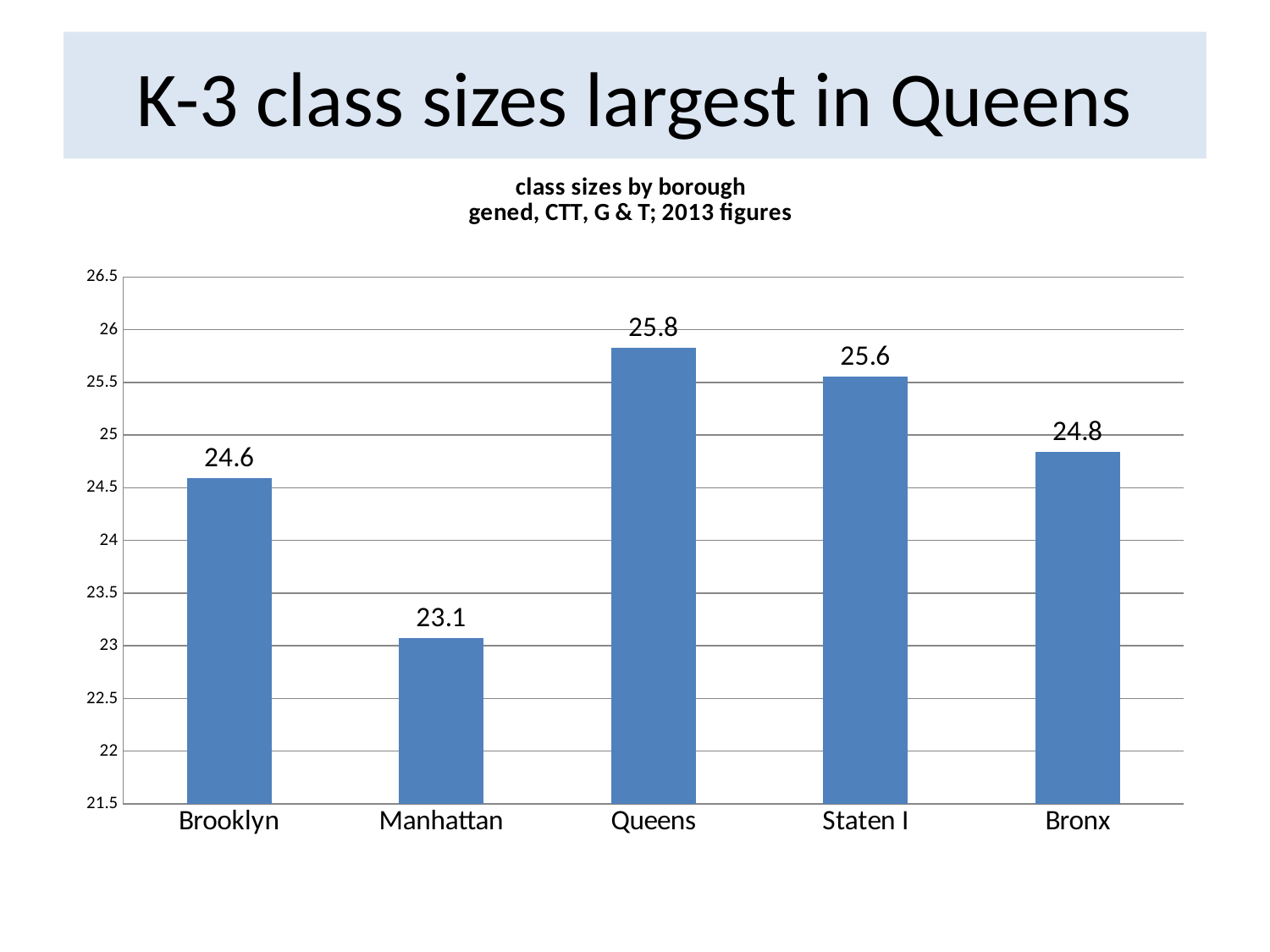
Which borough has the smallest class size? Manhattan What is the class size for Brooklyn? 24.6 Which borough has the largest class size? Queens What is the class size for Bronx? 24.8 What is the title of the chart? class sizes by borough gened, CTT, G & T; 2013 figures What type of chart is shown on the slide? Bar chart What is the class size for Manhattan? 23.1 What is the difference in class size between Staten I and Brooklyn? 1.0 What is the difference in class size between Queens and Manhattan? 2.7 Which has a larger class size, Bronx or Brooklyn? Bronx What is the class size for Queens? 25.8 How many boroughs are shown in the chart? 5